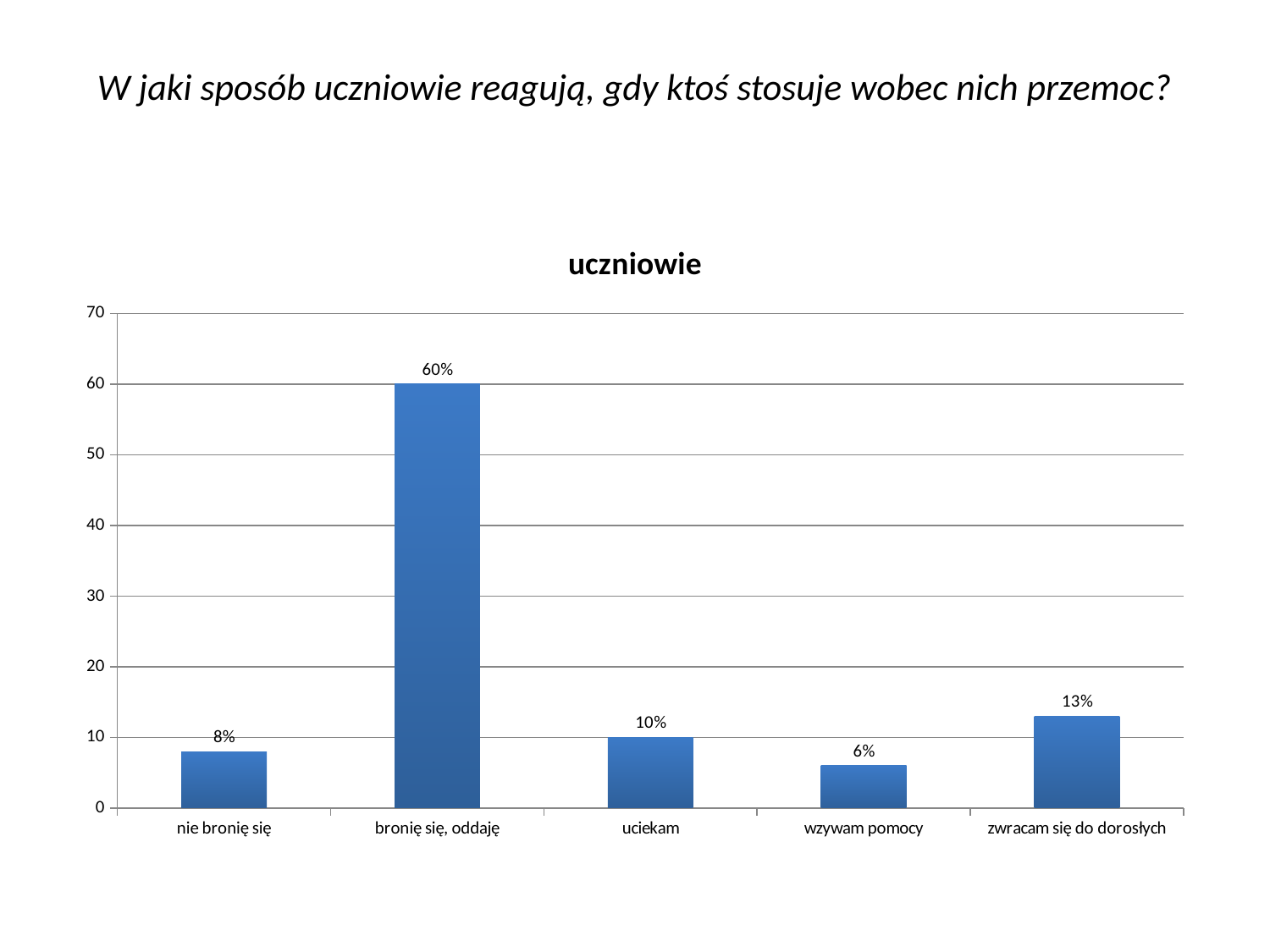
How many categories are shown on the x axis? 5 What is the value for "bronię się, oddaję"? 60% What is the difference between the values for "uciekam" and "nie bronię się"? 2% Which category has the lowest value? wzywam pomocy What is the value for "wzywam pomocy"? 6% Which is larger, the value for "uciekam" or the value for "wzywam pomocy"? uciekam What is the title of the chart? uczniowie What is the value for "zwracam się do dorosłych"? 13% What is the difference between the values for "bronię się, oddaję" and "zwracam się do dorosłych"? 47% Is the value for "zwracam się do dorosłych" greater or less than 10? greater Which category has the highest value? bronię się, oddaję What kind of chart is shown on the slide? bar chart